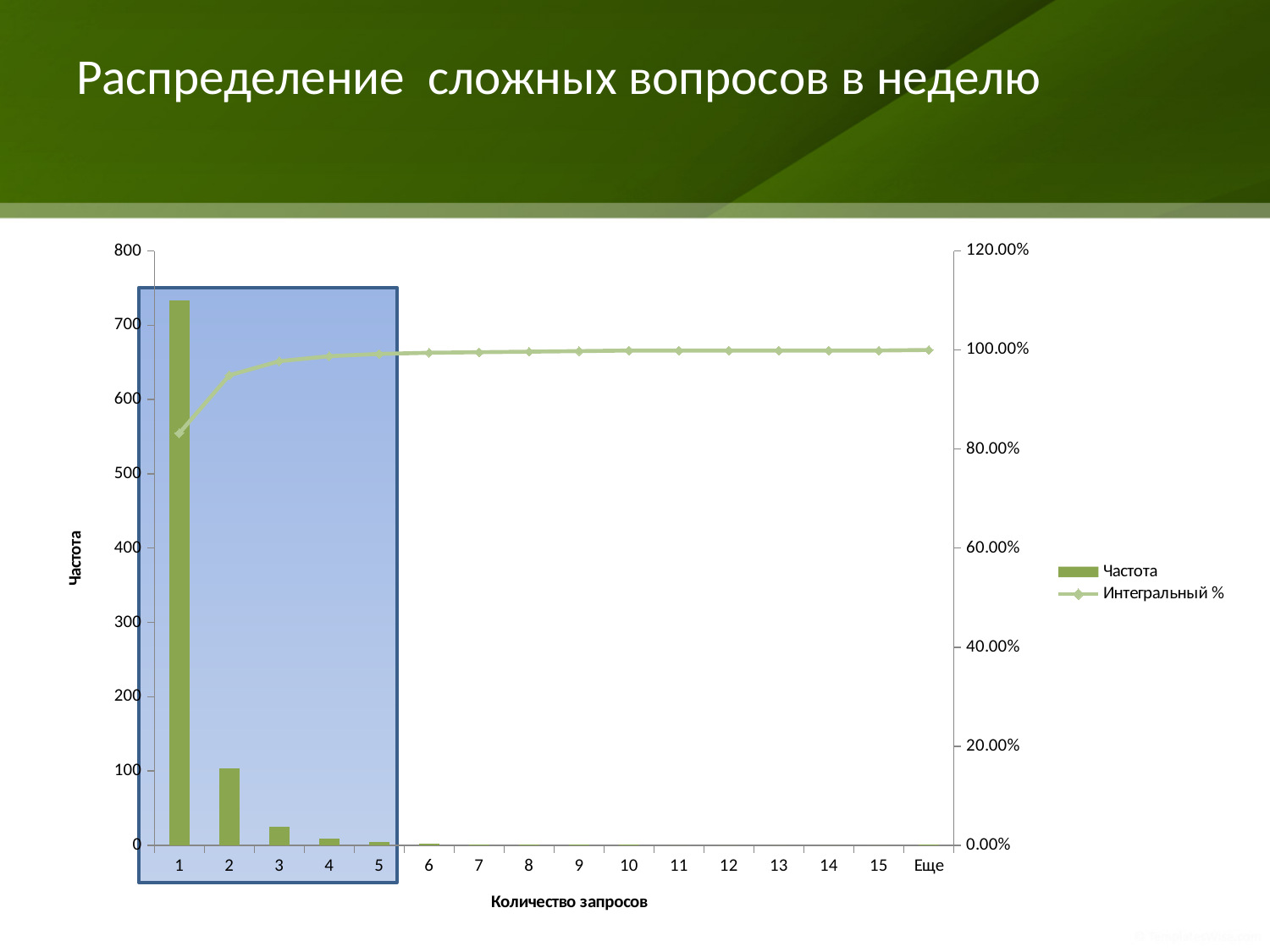
What kind of chart is shown on the slide? A combined bar and line chart Is the Частота value for category 1 greater or less than 700? greater How many categories are shown on the x axis? 16 What is the title of the x axis? Количество запросов Which has a larger Частота value, category 1 or category 2? 1 Is the Интегральный % value for category 1 greater or less than 100.00%? less Is the Частота value for category 3 greater or less than 100? less How many series does the legend list? 2 What are the two series named in the legend? Частота and Интегральный % Which category has the highest Частота bar? 1 Do the Частота bars rise or fall as the x axis goes from 1 to 5? fall